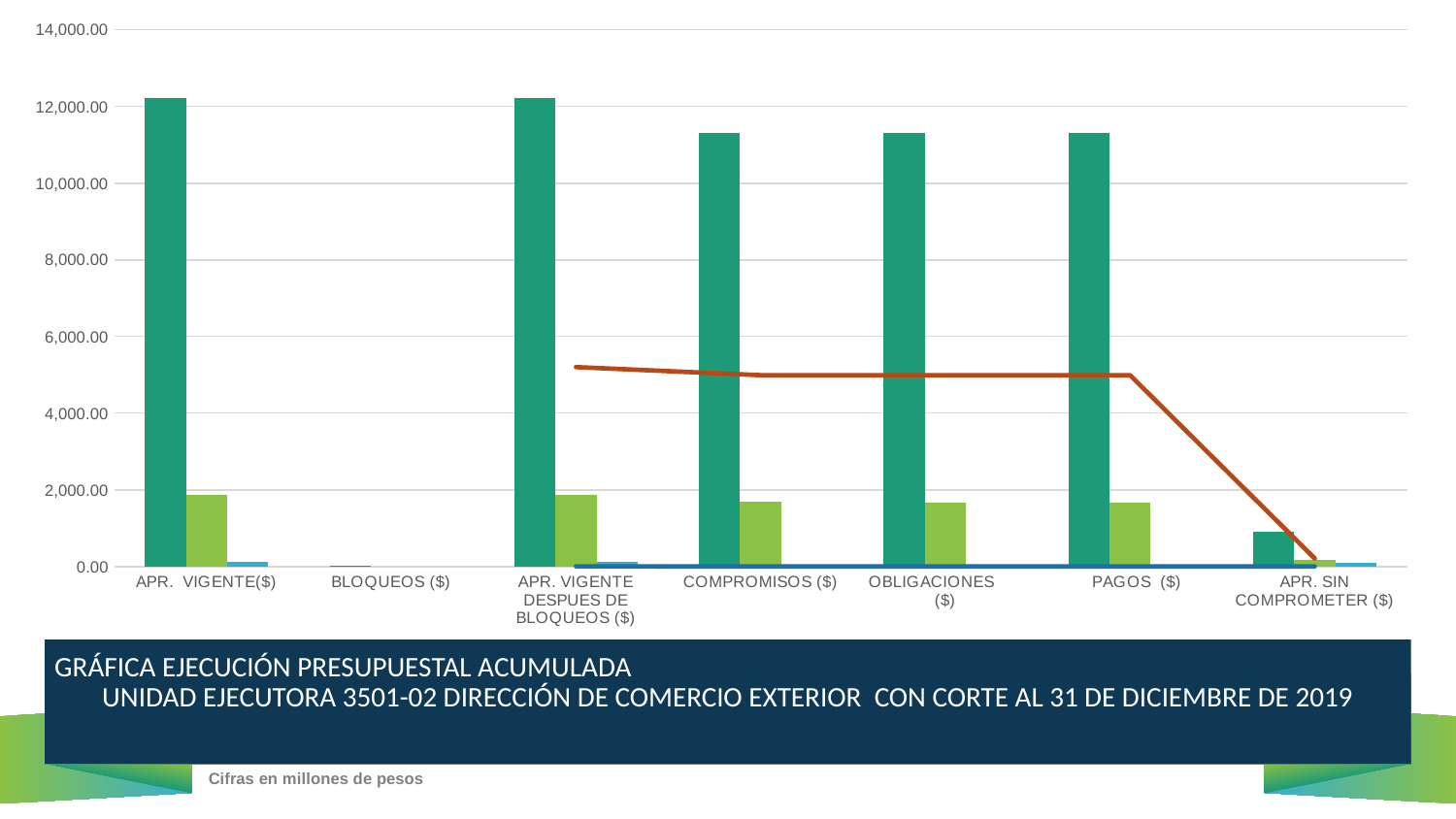
Is the value of the tall teal bar for COMPROMISOS ($) greater or less than 10,000.00? greater Is the value of the tall teal bar for APR. VIGENTE($) greater or less than 10,000.00? greater Does the orange line rise or fall between PAGOS ($) and APR. SIN COMPROMETER ($)? fall How many categories are shown along the x axis of the chart? 7 Is the value of the green bar for COMPROMISOS ($) greater or less than 2,000.00? less According to the note below the chart, in what units are the figures expressed? Cifras en millones de pesos Which teal bar is taller: PAGOS ($) or APR. SIN COMPROMETER ($)? PAGOS ($) What kind of chart is shown on the slide? bar chart with a line Which category has the lowest teal bar? BLOQUEOS ($) Which teal bar is taller: APR. VIGENTE($) or COMPROMISOS ($)? APR. VIGENTE($)